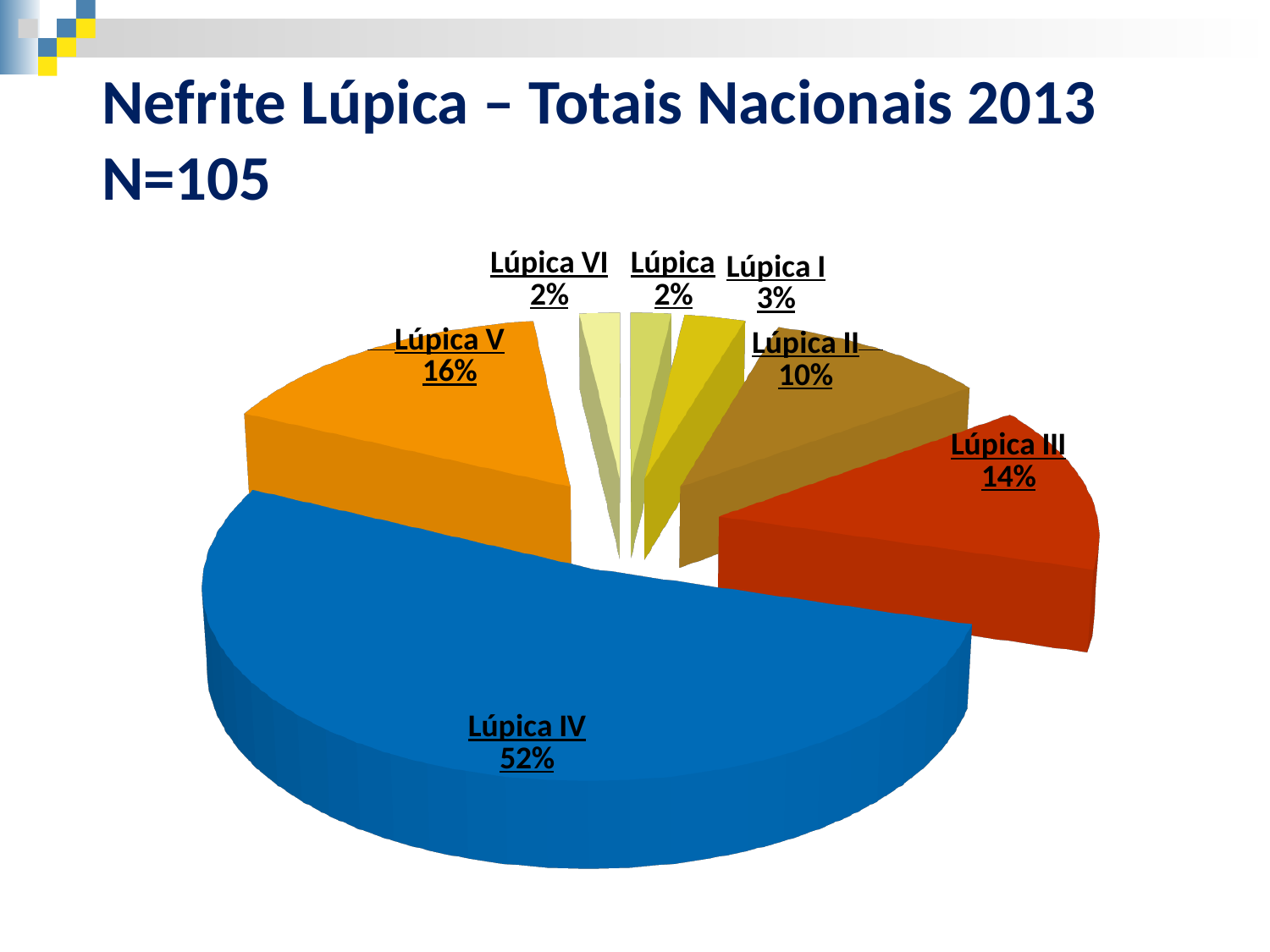
What percentage is shown for Lúpica I? 3% What percentage is shown for Lúpica VI? 2% What percentage is shown for Lúpica III? 14% What is the value of N stated in the slide title? 105 What percentage is shown for Lúpica II? 10% What share of the pie does Lúpica IV represent? 52% Which is larger, the share for Lúpica V or for Lúpica III? Lúpica V How many slices does the pie chart have? 7 What kind of chart is shown on the slide? Pie chart What is the difference in percentage points between Lúpica IV and Lúpica V? 36% What percentage is shown for Lúpica V? 16% Which category has the largest slice of the pie? Lúpica IV